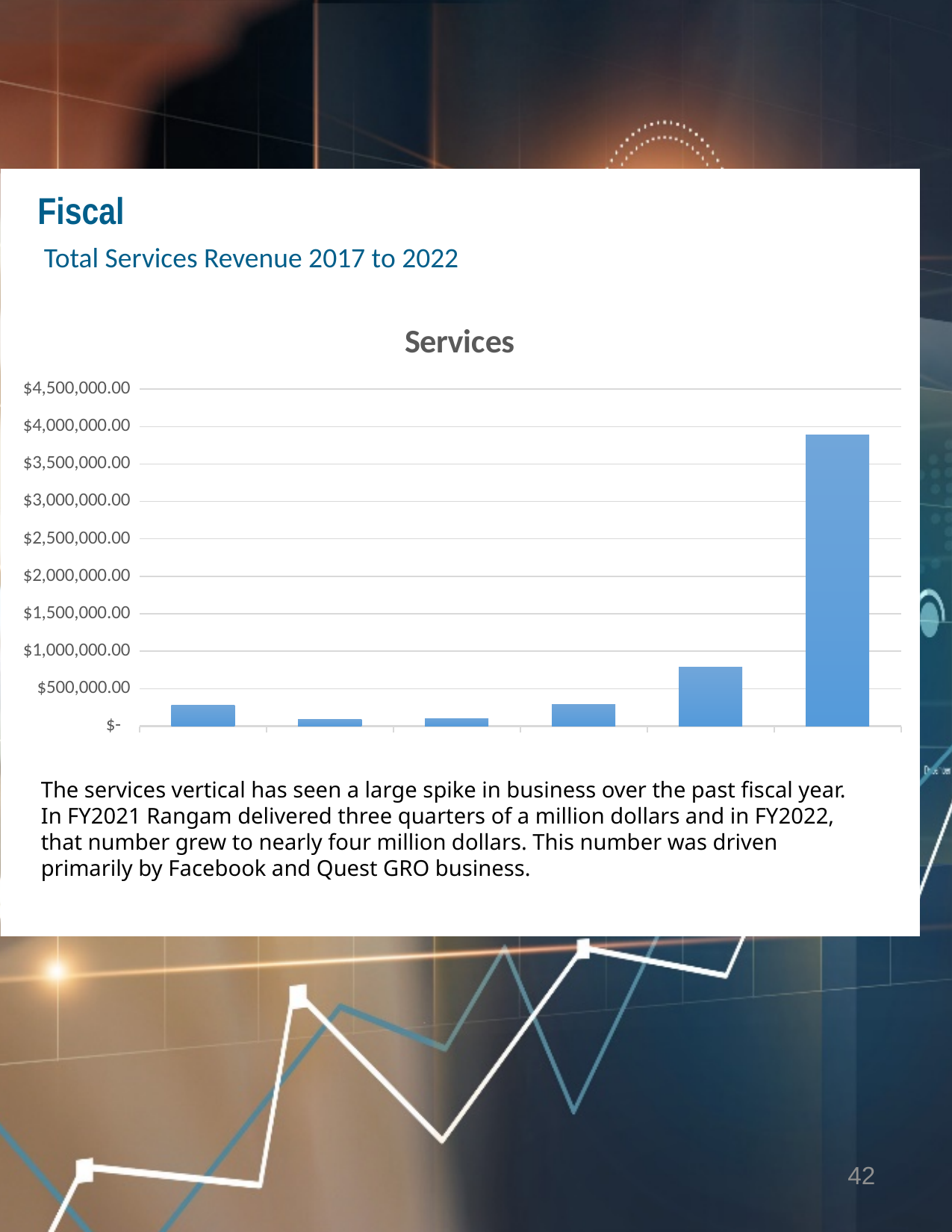
What kind of chart is shown on the slide? bar chart Is the value of the fifth bar from the left greater or less than $1,000,000.00? less Is the value of the fifth bar from the left greater or less than $500,000.00? greater What is the highest value labelled on the vertical axis of the chart? $4,500,000.00 Which bar in the chart is the tallest? the rightmost (sixth) bar Which is larger, the fifth bar from the left or the rightmost bar? the rightmost bar Is the value of the leftmost bar greater or less than $500,000.00? less What is the title of the chart? Services Is the rightmost bar higher or lower than the leftmost bar? higher How many bars does the Services chart contain? 6